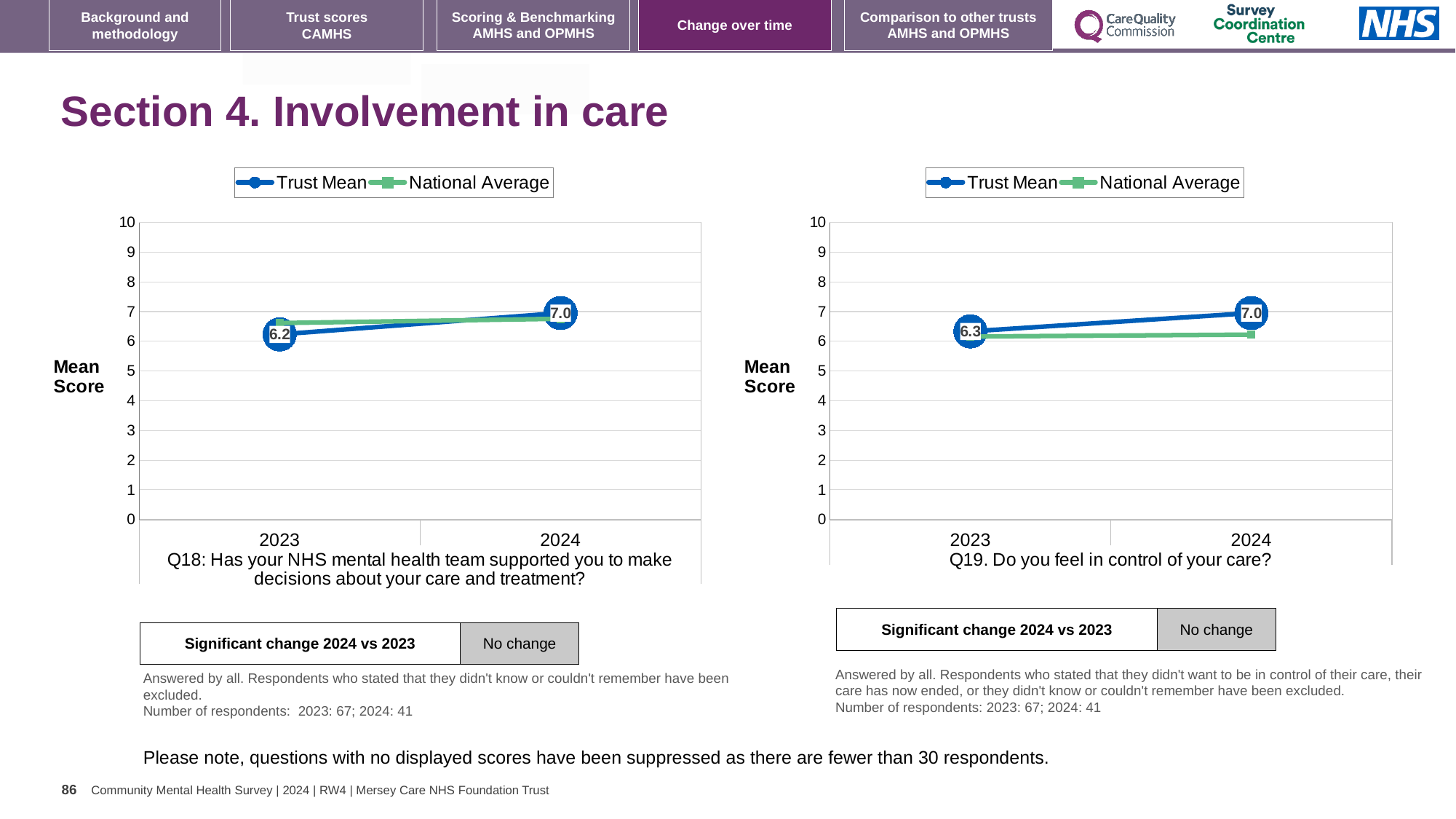
In the Q19 chart on the right, does the Trust Mean rise or fall from 2023 to 2024? rise In the Q18 chart on the left, by how much did the Trust Mean change from 2023 to 2024? 0.8 In the Q19 chart on the right, what is the Trust Mean score for 2024? 7.0 In the Q19 chart on the right, which series has the higher value in 2024, Trust Mean or National Average? Trust Mean In the Q19 chart on the right, by how much did the Trust Mean change from 2023 to 2024? 0.7 In the Q19 chart on the right, what is the Trust Mean score for 2023? 6.3 In the Q19 chart on the right, is the National Average value for 2024 greater or less than 7? less What type of chart is the Q18 chart on the left? line chart In the Q18 chart on the left, what is the Trust Mean score for 2024? 7.0 How many years are shown on the x axis of the Q18 chart on the left? 2 How many series does the legend of the Q19 chart on the right list? 2 In the Q18 chart on the left, what is the Trust Mean score for 2023? 6.2